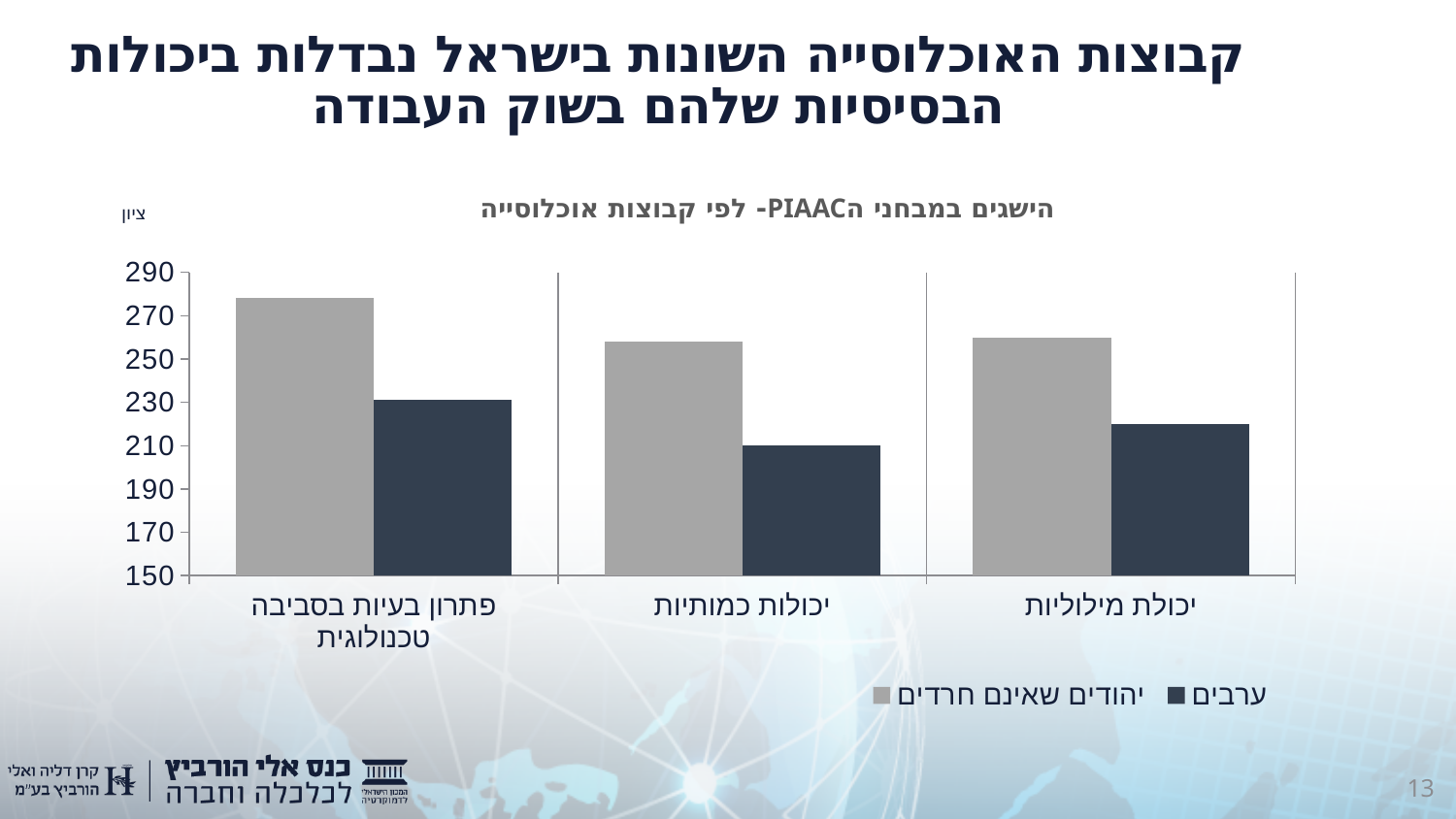
Is the value for יהודים שאינם חרדים in פתרון בעיות בסביבה טכנולוגית greater or less than 270? greater What kind of chart is shown on the slide? bar chart Is the value for יהודים שאינם חרדים in יכולות כמותיות greater or less than 250? greater How many categories are shown on the x axis of the chart? 3 In which category is the value for ערבים lowest? יכולות כמותיות In יכולת מילוליות, which series has the larger value, יהודים שאינם חרדים or ערבים? יהודים שאינם חרדים In which category is the value for יהודים שאינם חרדים highest? פתרון בעיות בסביבה טכנולוגית In which category is the value for ערבים highest? פתרון בעיות בסביבה טכנולוגית Which series is shown in dark blue in the chart? ערבים How many series does the chart's legend list? 2 Is the value for ערבים in יכולת מילוליות greater or less than 230? less What is the title of the chart? הישגים במבחני הPIAAC- לפי קבוצות אוכלוסייה